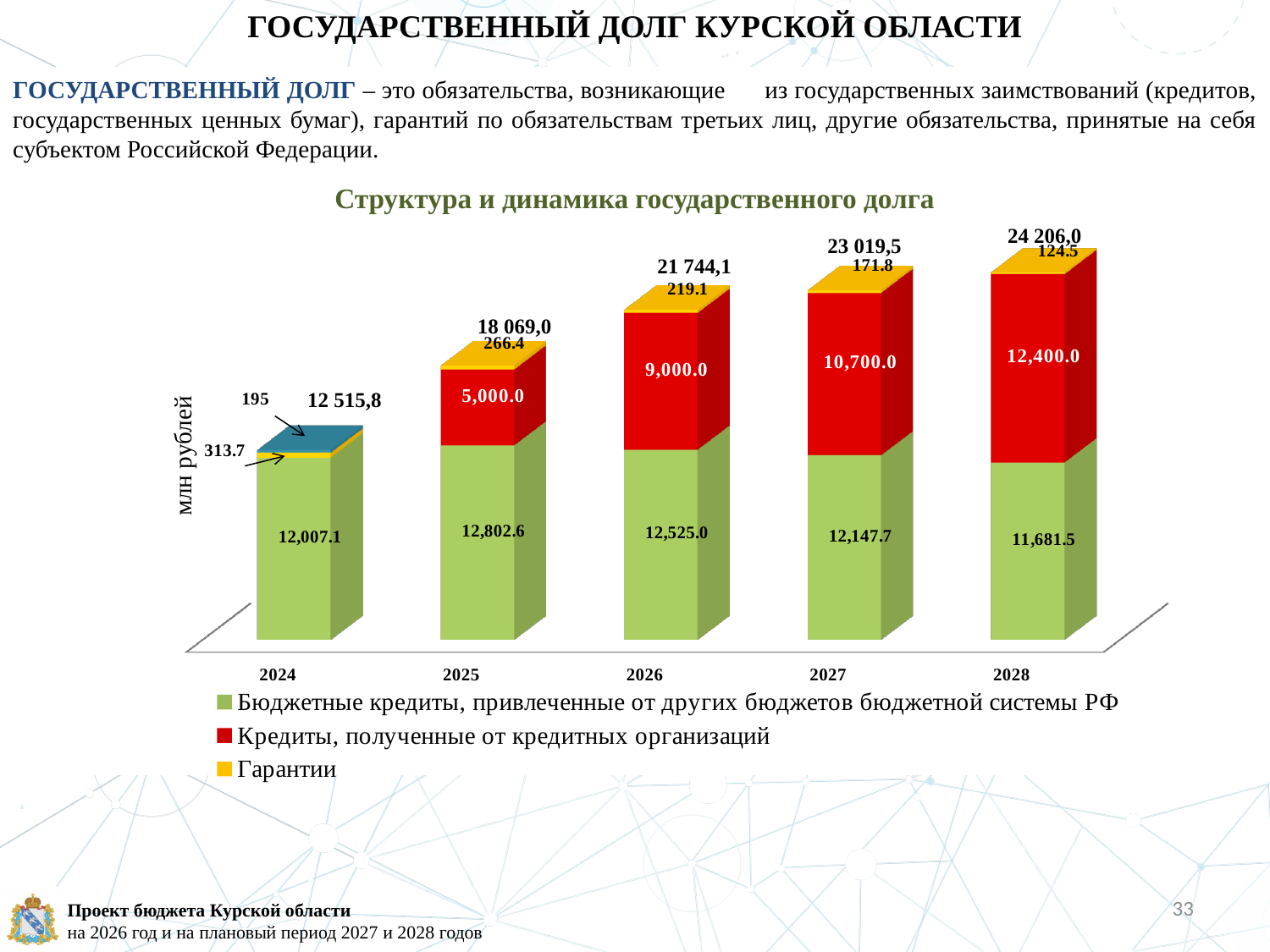
Каков объём бюджетных кредитов, привлеченных от других бюджетов бюджетной системы РФ, в 2025 году? 12,802.6 Каков объём кредитов, полученных от кредитных организаций, в 2027 году? 10,700.0 Каков общий объём государственного долга в 2026 году? 21 744,1 В каком году общий объём государственного долга наибольший? 2028 Как меняется общий объём государственного долга с 2024 по 2028 год? Растёт Каков объём гарантий в 2028 году? 124.5 Какой тип диаграммы показан на слайде «Структура и динамика государственного долга»? Столбчатая диаграмма с накоплением Сколько лет (категорий) показано на оси X диаграммы? 5 Сколько серий перечислено в легенде диаграммы? 3 В каком году объём бюджетных кредитов, привлеченных от других бюджетов бюджетной системы РФ, наименьший? 2028 На сколько объём кредитов, полученных от кредитных организаций, в 2028 году больше, чем в 2025 году? 7,400.0 Что больше в 2028 году: бюджетные кредиты или кредиты, полученные от кредитных организаций? Кредиты, полученные от кредитных организаций